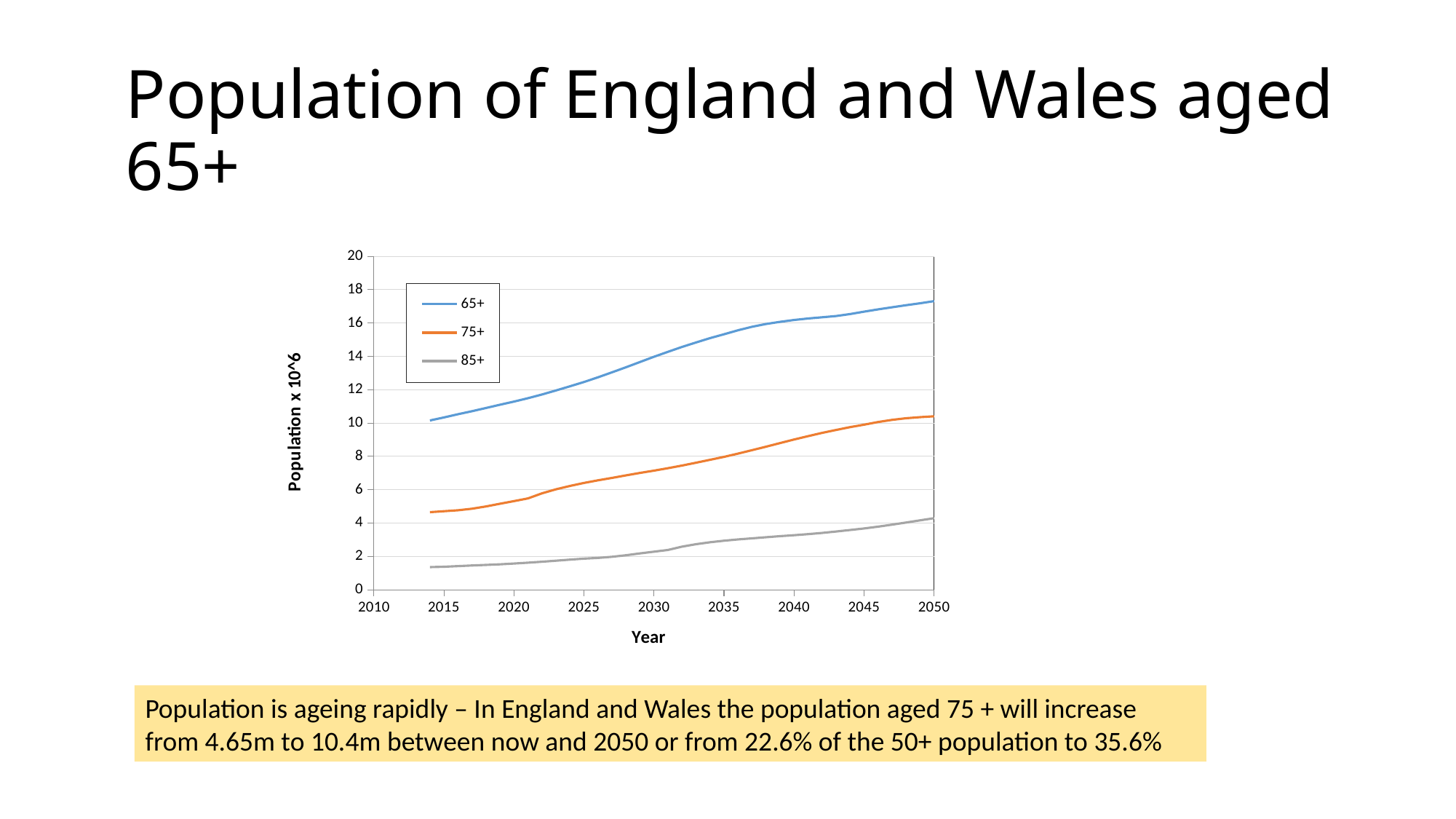
What is the label on the chart's horizontal axis? Year What is the label on the chart's vertical axis? Population x 10^6 Is the value for the 65+ series in 2050 greater or less than 16? greater Is the value for the 85+ series in 2050 greater or less than 6? less Which series has the highest values throughout the chart? 65+ Which is larger in 2050, the value for 65+ or the value for 75+? 65+ Is the value for the 65+ series in 2040 greater or less than 14? greater Do the values for the 65+ series rise or fall from 2014 to 2050? rise Which series has the lowest values throughout the chart? 85+ How many series does the chart's legend list? 3 What kind of chart is shown on the slide? line chart